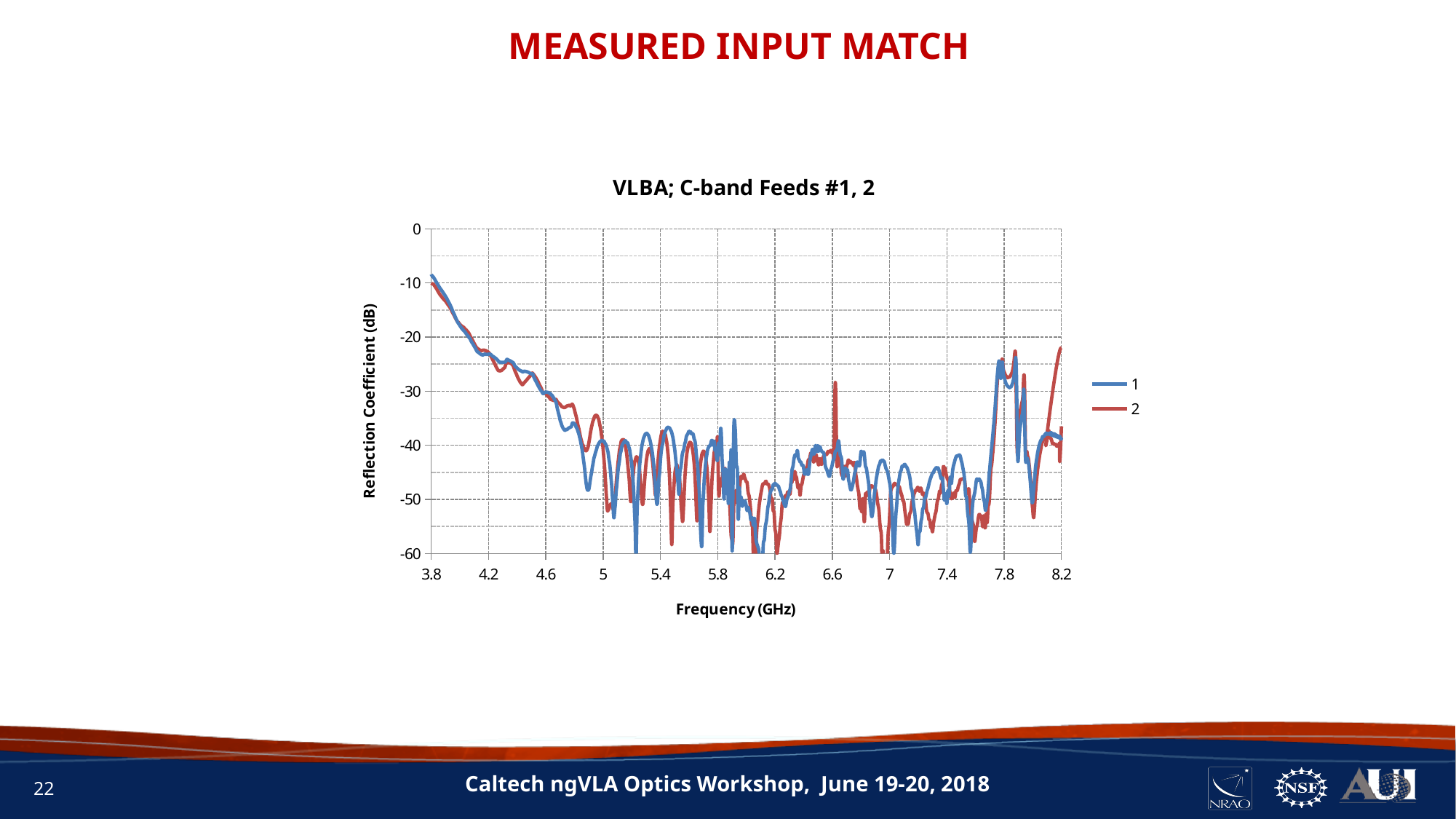
Do the values for series 1 rise or fall between 3.8 GHz and 5 GHz? fall Do the values for series 2 rise or fall between 7.4 GHz and 7.8 GHz? rise Is the value for series 2 at 8.2 GHz greater or less than -30? greater How many series does the legend list? 2 What is the label of the x axis? Frequency (GHz) Is the value for series 1 at 8.2 GHz greater or less than -30? less What kind of chart is shown on the slide? line chart Is the value for series 1 at 4.2 GHz greater or less than -30? greater What is the title of the chart? VLBA; C-band Feeds #1, 2 At 8.2 GHz, which series has the larger value, series 1 or series 2? series 2